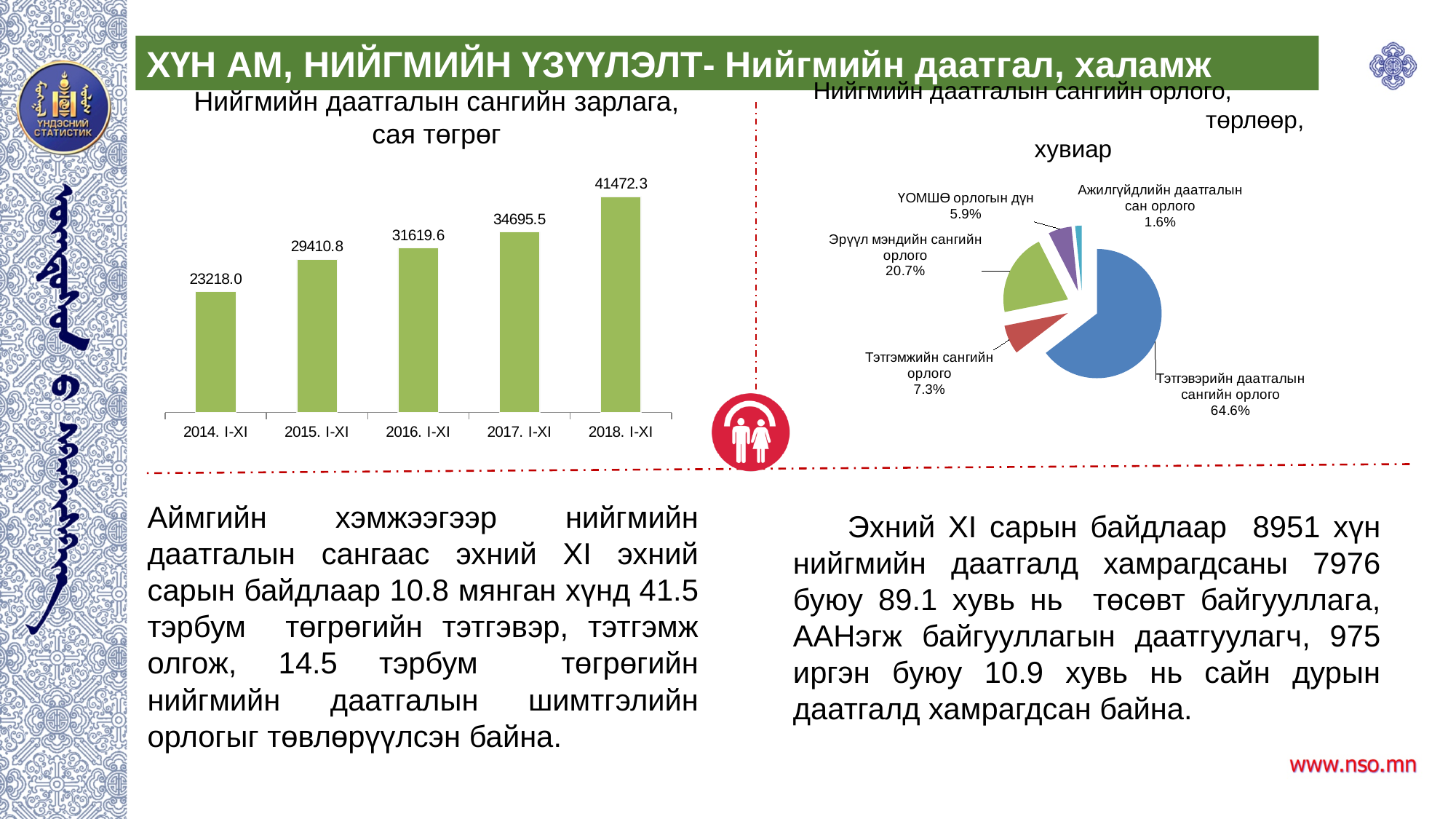
In the bar chart 'Нийгмийн даатгалын сангийн зарлага, сая төгрөг', which period has the highest value? 2018. I-XI In the bar chart 'Нийгмийн даатгалын сангийн зарлага, сая төгрөг', what is the value for 2014. I-XI? 23218.0 How many bars are in the bar chart 'Нийгмийн даатгалын сангийн зарлага, сая төгрөг'? 5 In the pie chart 'Нийгмийн даатгалын сангийн орлого, төрлөөр, хувиар', which is larger: 'Тэтгэмжийн сангийн орлого' or 'ҮОМШӨ орлогын дүн'? Тэтгэмжийн сангийн орлого In the pie chart 'Нийгмийн даатгалын сангийн орлого, төрлөөр, хувиар', which category has the smallest share? Ажилгүйдлийн даатгалын сан орлого In the bar chart 'Нийгмийн даатгалын сангийн зарлага, сая төгрөг', what is the value for 2016. I-XI? 31619.6 In the pie chart 'Нийгмийн даатгалын сангийн орлого, төрлөөр, хувиар', what share is 'Эрүүл мэндийн сангийн орлого'? 20.7% In the pie chart 'Нийгмийн даатгалын сангийн орлого, төрлөөр, хувиар', what share is 'Тэтгэврийн даатгалын сангийн орлого'? 64.6% In the bar chart 'Нийгмийн даатгалын сангийн зарлага, сая төгрөг', do the values rise or fall from 2014. I-XI to 2018. I-XI? rise In the bar chart 'Нийгмийн даатгалын сангийн зарлага, сая төгрөг', what is the value for 2018. I-XI? 41472.3 In the bar chart 'Нийгмийн даатгалын сангийн зарлага, сая төгрөг', which period has the lowest value? 2014. I-XI In the bar chart 'Нийгмийн даатгалын сангийн зарлага, сая төгрөг', what is the difference between the values for 2018. I-XI and 2017. I-XI? 6776.8